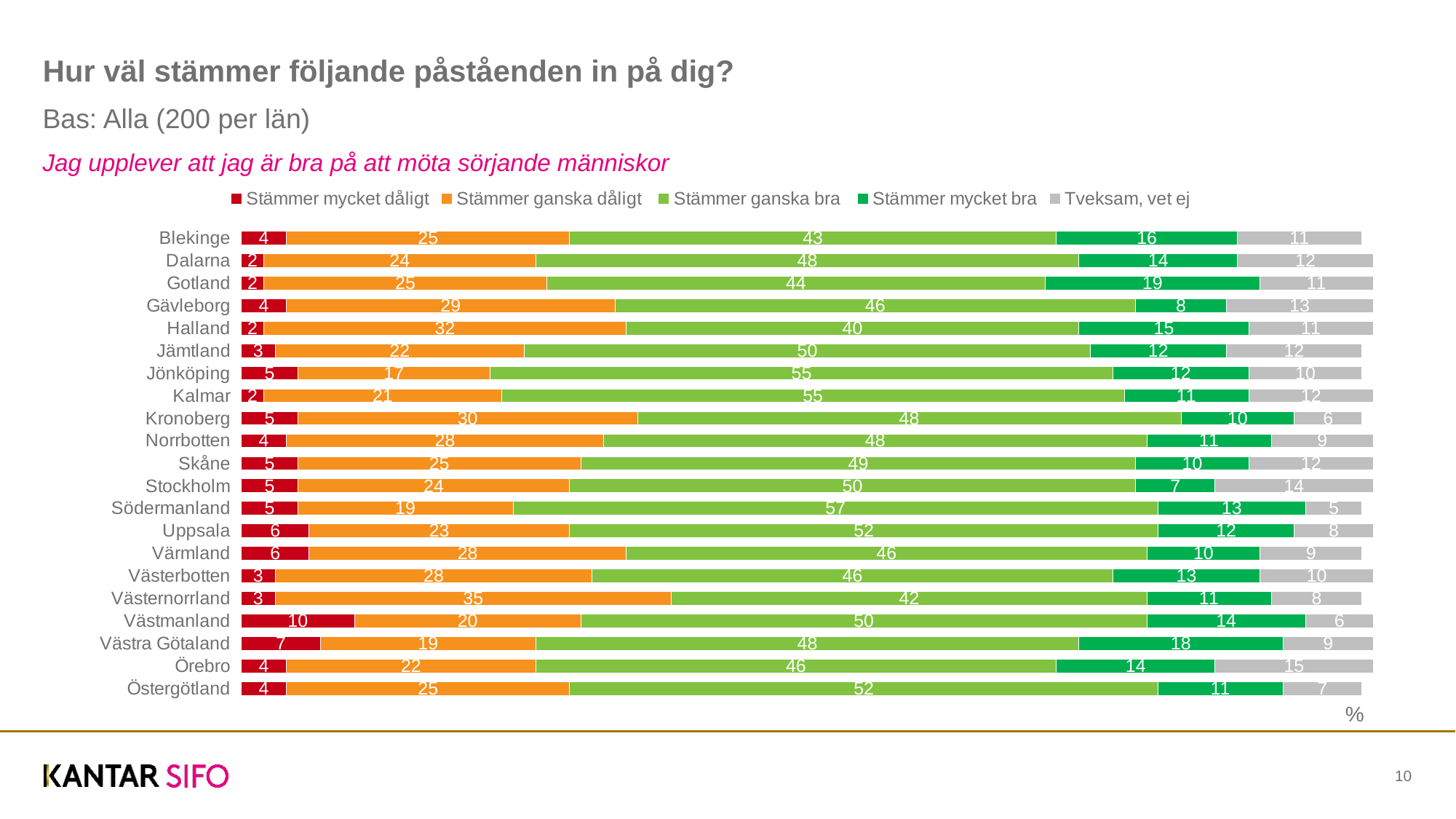
What is the value for 'Tveksam, vet ej' for Örebro? 15 What kind of chart is shown on the slide? Stacked bar chart Which is larger: the 'Stämmer ganska bra' value for Jönköping or for Blekinge? Jönköping What is the value for 'Stämmer mycket dåligt' for Västmanland? 10 Which county has the lowest value for 'Stämmer mycket bra'? Stockholm Which county has the highest value for 'Stämmer mycket bra'? Gotland How many counties (categories) are shown in the chart? 21 What is the difference between the 'Stämmer mycket bra' values for Gotland and Stockholm? 12 What is the total of the stacked bar for Dalarna? 100 What is the value for 'Stämmer ganska bra' for Södermanland? 57 Which county has the highest value for 'Stämmer ganska dåligt'? Västernorrland How many series does the legend list? 5